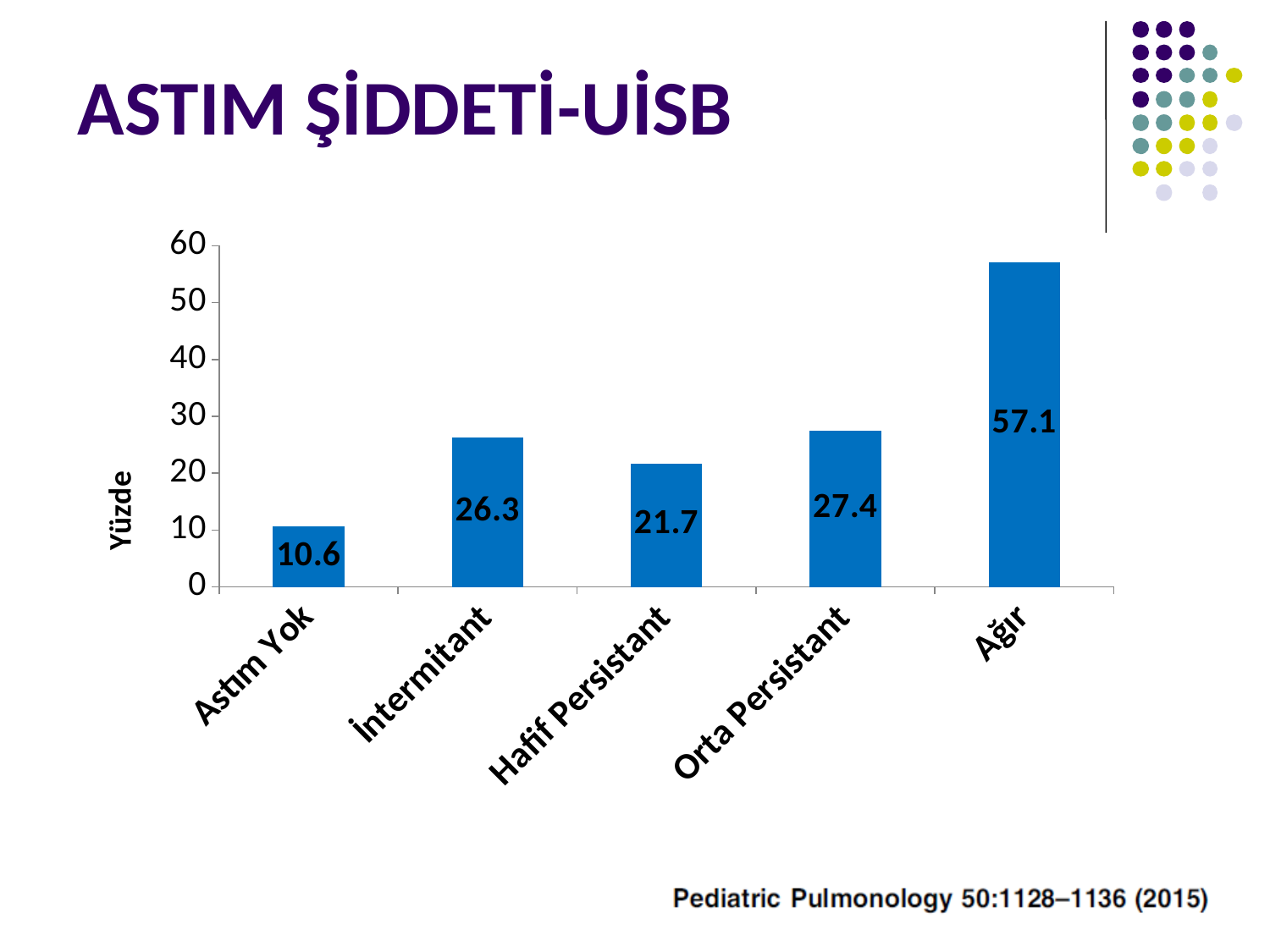
What is the value for İntermitant? 26.3 Which is larger, the value for İntermitant or the value for Hafif Persistant? İntermitant What kind of chart is shown on the slide? Bar chart Which category has the lowest value? Astım Yok Which category has the highest value? Ağır What is the label of the y axis? Yüzde What is the difference between the values for Ağır and Astım Yok? 46.5 How many categories are shown on the x axis? 5 What is the value for Astım Yok? 10.6 What is the value for Orta Persistant? 27.4 What is the value for Ağır? 57.1 What is the value for Hafif Persistant? 21.7